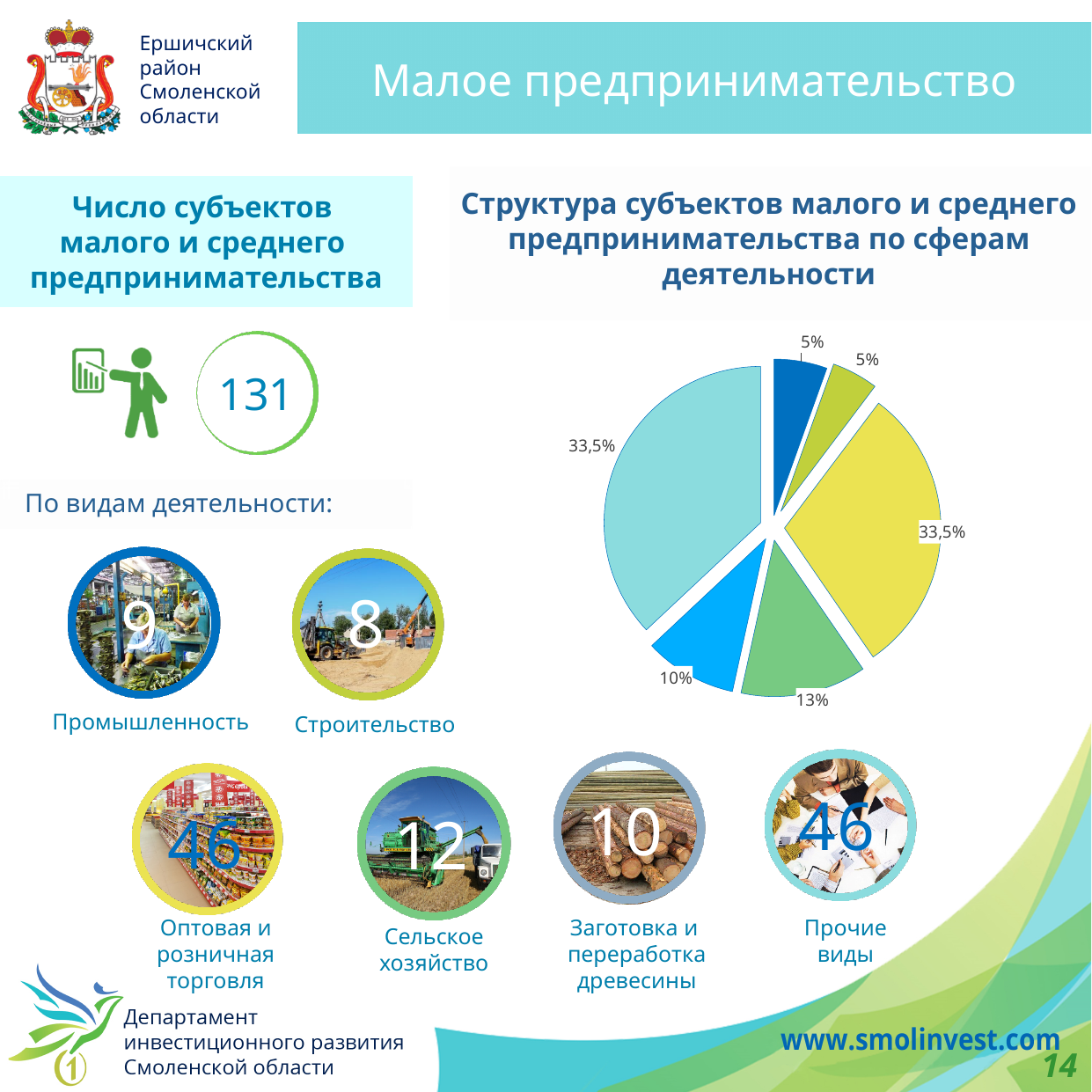
What percentage is shown for the dark blue slice of the pie chart? 5% What percentage is shown for the yellow slice of the pie chart? 33,5% What is the difference between the 13% slice and the 10% slice of the pie chart? 3% How many slices does the pie chart have? 6 What percentage is shown for the bright cyan slice at the bottom left of the pie chart? 10% What kind of chart is shown under the title "Структура субъектов малого и среднего предпринимательства по сферам деятельности"? pie chart What percentage is shown for the green slice at the bottom of the pie chart? 13% What is the smallest percentage value labelled on the pie chart? 5% What is the title of the pie chart? Структура субъектов малого и среднего предпринимательства по сферам деятельности What is the largest percentage value labelled on the pie chart? 33,5% Which is larger in the pie chart: the green slice labelled 13% or the bright cyan slice labelled 10%? the green slice (13%) What percentage is shown for the large pale blue slice on the left of the pie chart? 33,5%